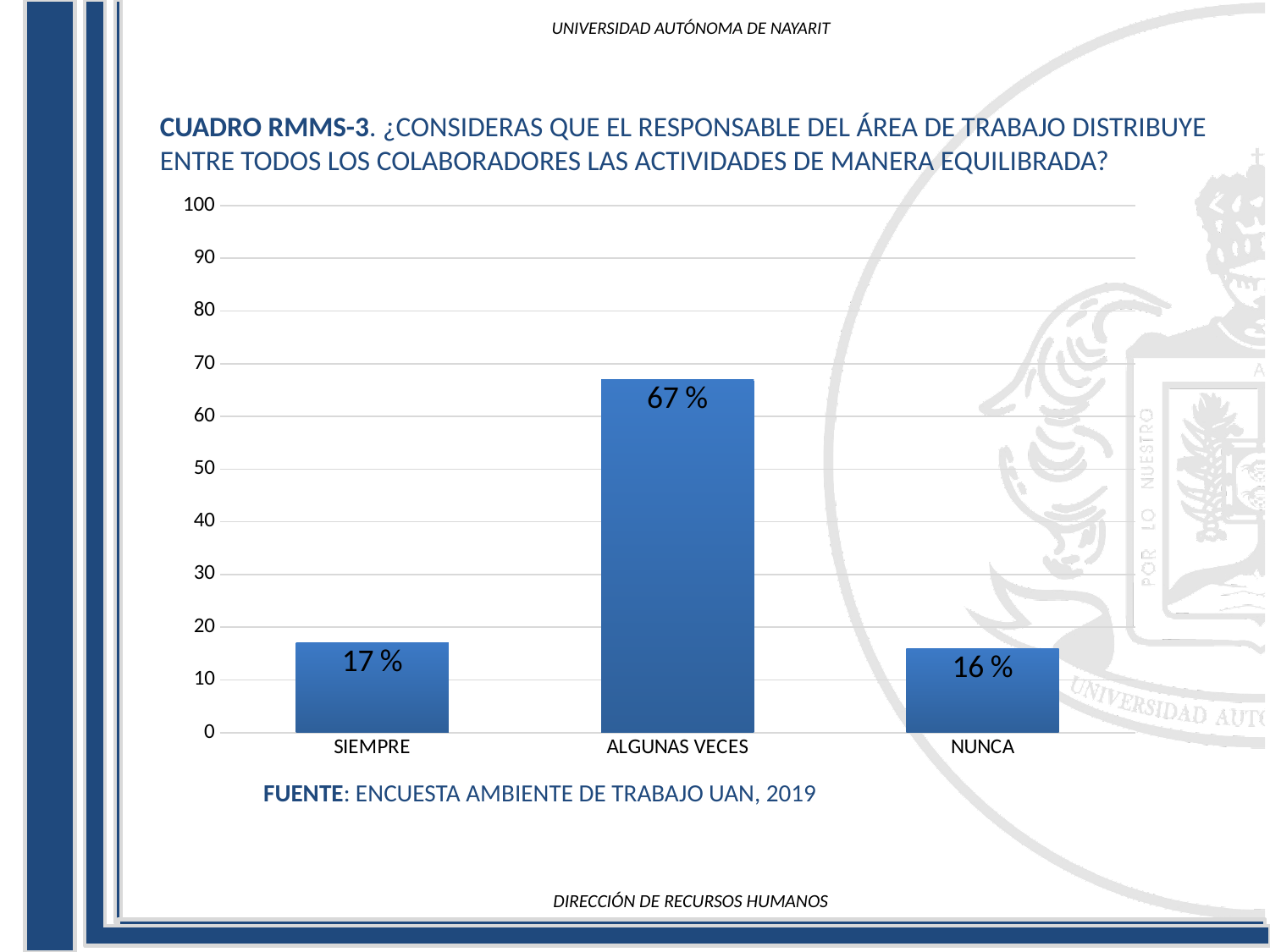
Which is larger, the value for ALGUNAS VECES or the value for NUNCA? ALGUNAS VECES What is the value for SIEMPRE? 17 % Is the value for ALGUNAS VECES greater or less than 50? greater How many categories are shown on the x axis? 3 What is the value for ALGUNAS VECES? 67 % What source is cited below the chart? ENCUESTA AMBIENTE DE TRABAJO UAN, 2019 What is the difference between the values for SIEMPRE and NUNCA? 1 % What kind of chart is shown on the slide? bar chart What is the value for NUNCA? 16 % Which category has the highest value? ALGUNAS VECES Is the value for NUNCA greater or less than 20? less What is the difference between the values for ALGUNAS VECES and SIEMPRE? 50 %